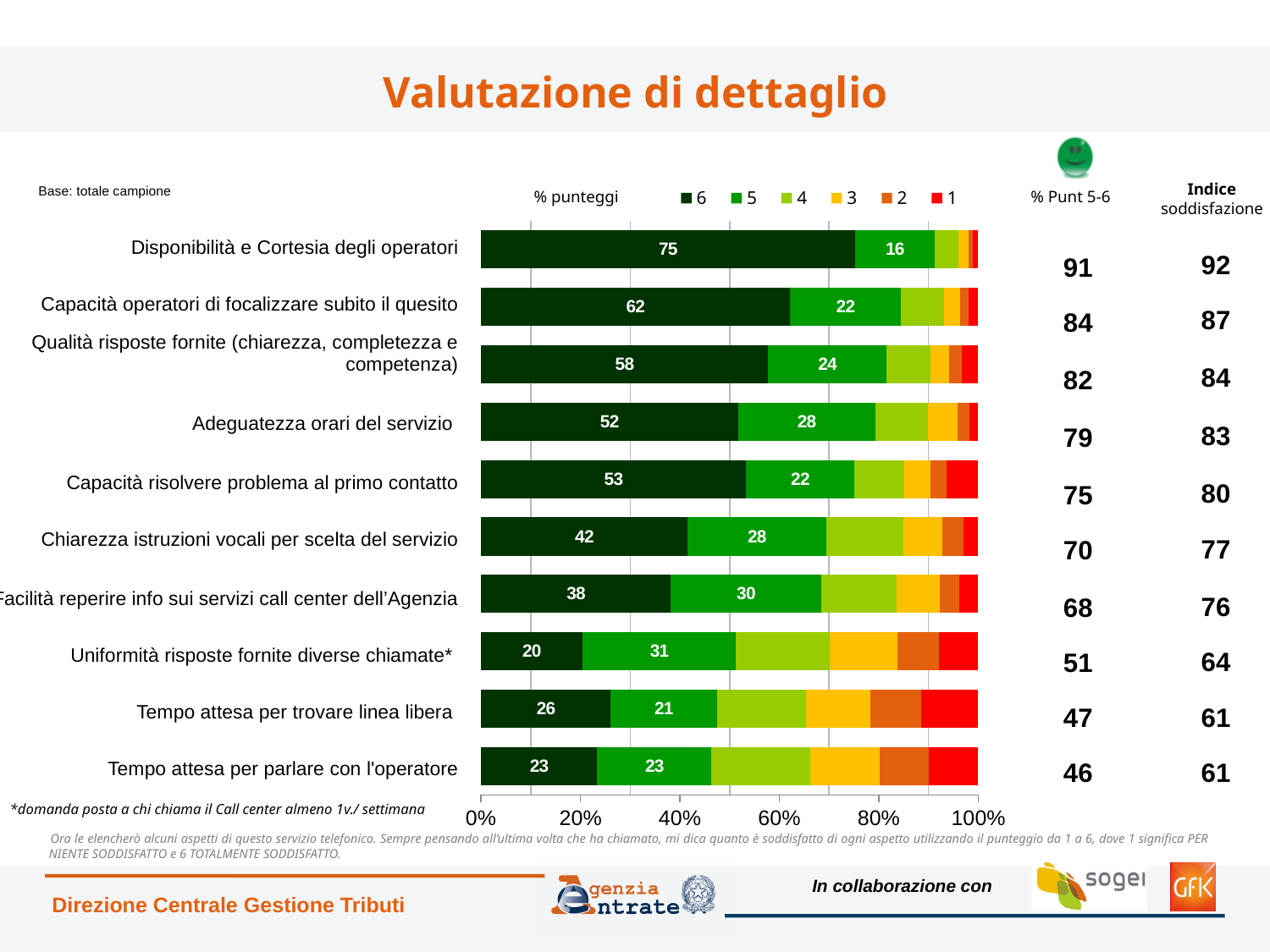
What kind of chart is shown on the slide? Stacked bar chart How many categories are shown on the chart? 10 Which category has the highest value for the "6" series? Disponibilità e Cortesia degli operatori What is the combined value of the "6" and "5" series for "Tempo attesa per parlare con l'operatore"? 46 Which category has the lowest value for the "6" series? Uniformità risposte fornite diverse chiamate* For "Capacità operatori di focalizzare subito il quesito", what is the difference between the "6" value and the "5" value? 40 Is the combined "6" and "5" portion of the bar for "Tempo attesa per trovare linea libera" greater or less than 60%? less What is the value of the "6" series for "Disponibilità e Cortesia degli operatori"? 75 How many series does the legend list? 6 What is the value of the "5" series for "Adeguatezza orari del servizio"? 28 Which has the larger "6" value: "Tempo attesa per trovare linea libera" or "Tempo attesa per parlare con l'operatore"? Tempo attesa per trovare linea libera What is the value of the "5" series for "Uniformità risposte fornite diverse chiamate*"? 31